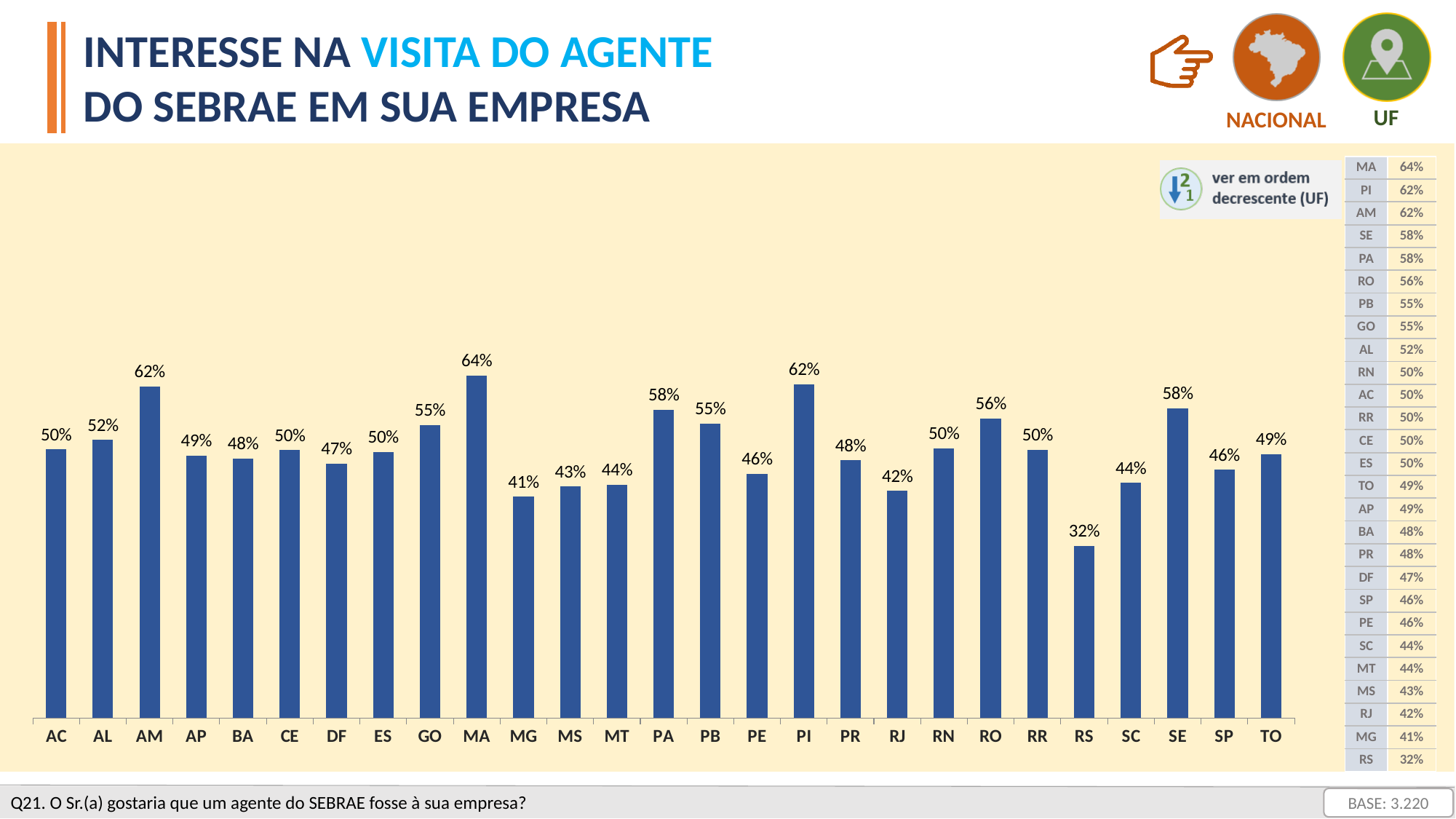
Which UF has the highest value? MA What is the value for RS? 32% Which is larger, the value for AM or the value for AP? AM What kind of chart is shown on the slide? Bar chart How many UFs are shown on the x axis of the chart? 27 What is the difference between the values for MA and RS? 32% Which is larger, the value for MG or the value for SE? SE What is the base (number of respondents) shown on the slide? 3.220 What is the difference between the values for PA and PE? 12% Which UF has the lowest value? RS What is the value for GO? 55% What is the value for MA? 64%